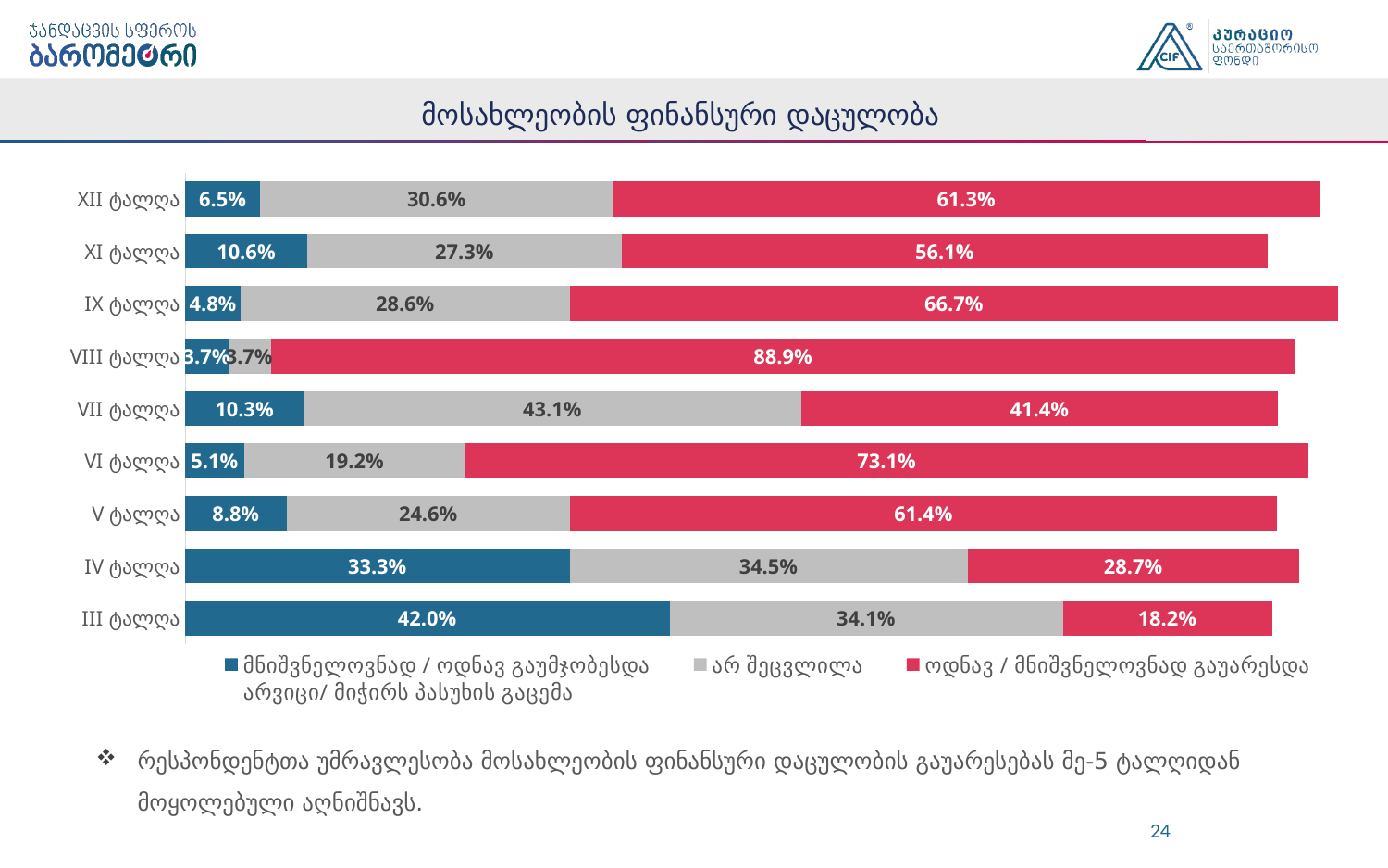
Which category has the highest value in the red series (ოდნავ / მნიშვნელოვნად გაუარესდა)? VIII ტალღა What kind of chart is shown on the slide? stacked horizontal bar chart What is the value of the red series (ოდნავ / მნიშვნელოვნად გაუარესდა) for VIII ტალღა? 88.9% What is the value of the red series for XII ტალღა? 61.3% What is the difference between the red series values for IX ტალღა and XI ტალღა? 10.6% Which category has the lowest value in the red series? III ტალღა Which category has the highest value in the blue series? III ტალღა Which is larger for IV ტალღა: the blue series value or the red series value? the blue series (33.3%) How many categories (waves) are shown on the chart? 9 What is the value of the grey series (არ შეცვლილა) for VII ტალღა? 43.1% What is the value of the blue series for III ტალღა? 42.0%